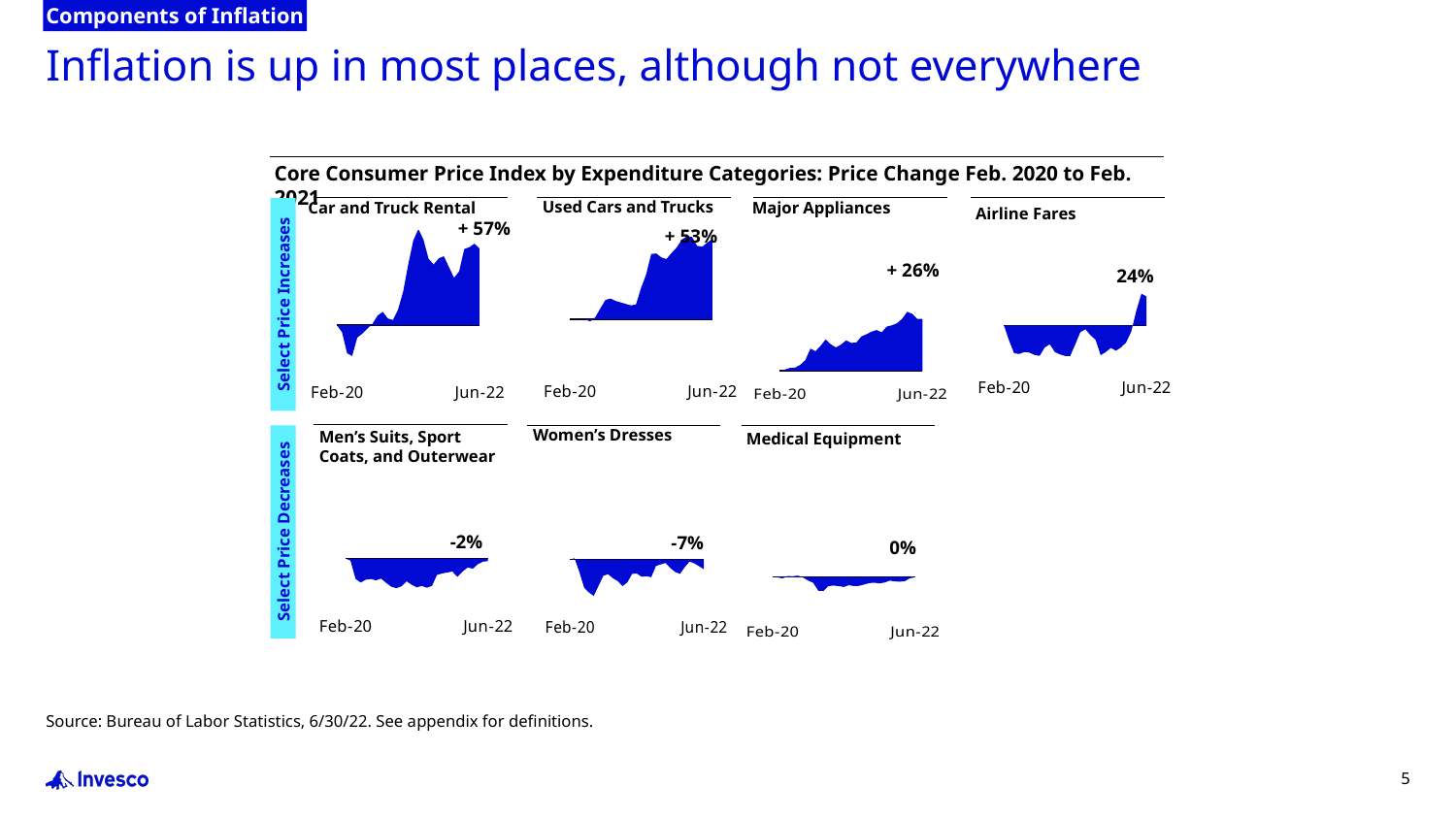
In the Car and Truck Rental chart, what is the price change from Feb. 2020 to Jun. 2022 shown on the label? + 57% In the Women's Dresses chart, what price change is labelled? -7% How many small charts are shown on the slide in total? 7 What is the difference in percentage points between the labelled price change for Car and Truck Rental and for Used Cars and Trucks? 4 percentage points In the Medical Equipment chart, what price change is labelled? 0% Across all the charts on the slide, which expenditure category shows the largest price decrease? Women's Dresses Across all the charts on the slide, which expenditure category shows the largest price increase? Car and Truck Rental Which has the larger labelled price change, Major Appliances or Airline Fares? Major Appliances In the Used Cars and Trucks chart, what price change is labelled? + 53% In the Major Appliances chart, what price change is labelled? + 26% What kind of chart is used for each expenditure category on the slide? Area chart In the Airline Fares chart, what price change is labelled? 24%